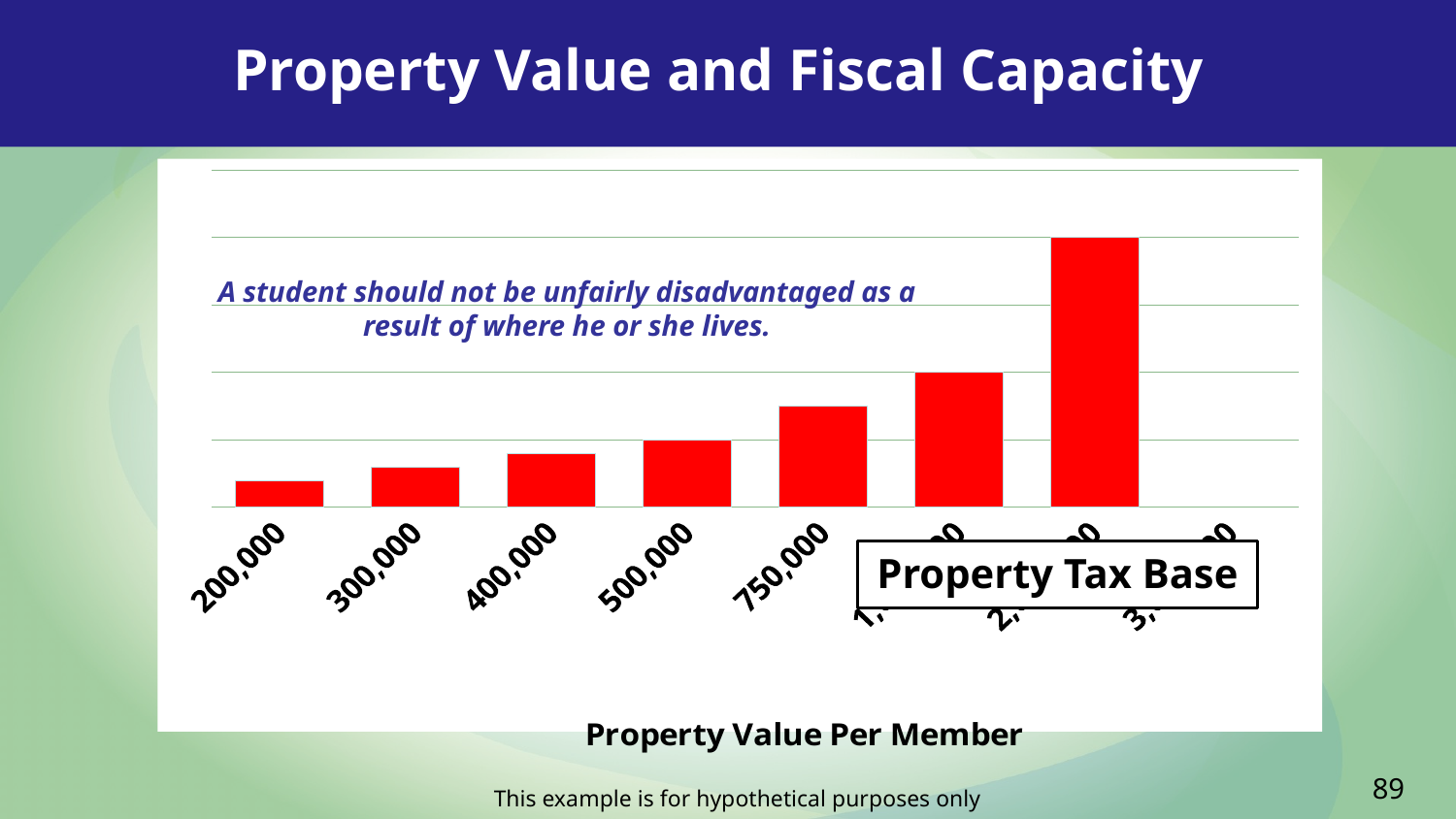
What kind of chart is shown on the slide? bar chart Is the Property Tax Base value larger for 300,000 or for 400,000? 400,000 How many bars are plotted in the chart? 7 What colour are the bars in the chart? red Which category has the lowest Property Tax Base value? 200,000 Do the bar values rise or fall as property value per member increases along the x axis? rise Is the Property Tax Base value larger for 750,000 or for 500,000? 750,000 What is the title of the x axis? Property Value Per Member